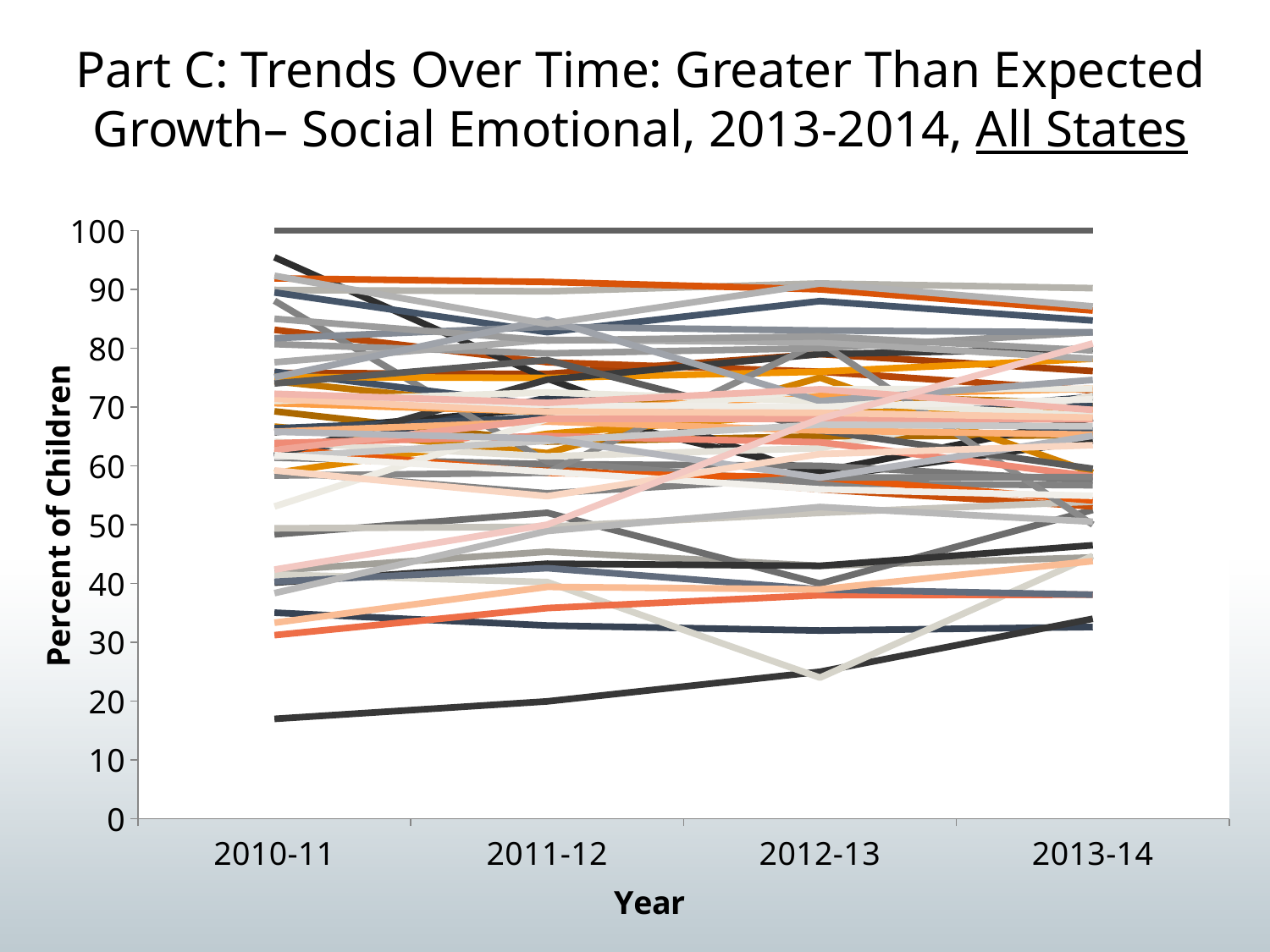
Is the highest value plotted for 2010-11 greater or less than 90? greater Is the lowest value plotted for 2013-14 greater or less than 30? greater Is the lowest value plotted for 2010-11 greater or less than 20? less What is the label of the x axis of the chart? Year How many years are shown along the x axis of the chart? 4 What kind of chart is shown on the slide? line chart Which year is the last category on the x axis of the chart? 2013-14 What is the label of the y axis of the chart? Percent of Children Does the lowest line on the chart rise or fall from 2010-11 to 2013-14? rise Which year is the first category on the x axis of the chart? 2010-11